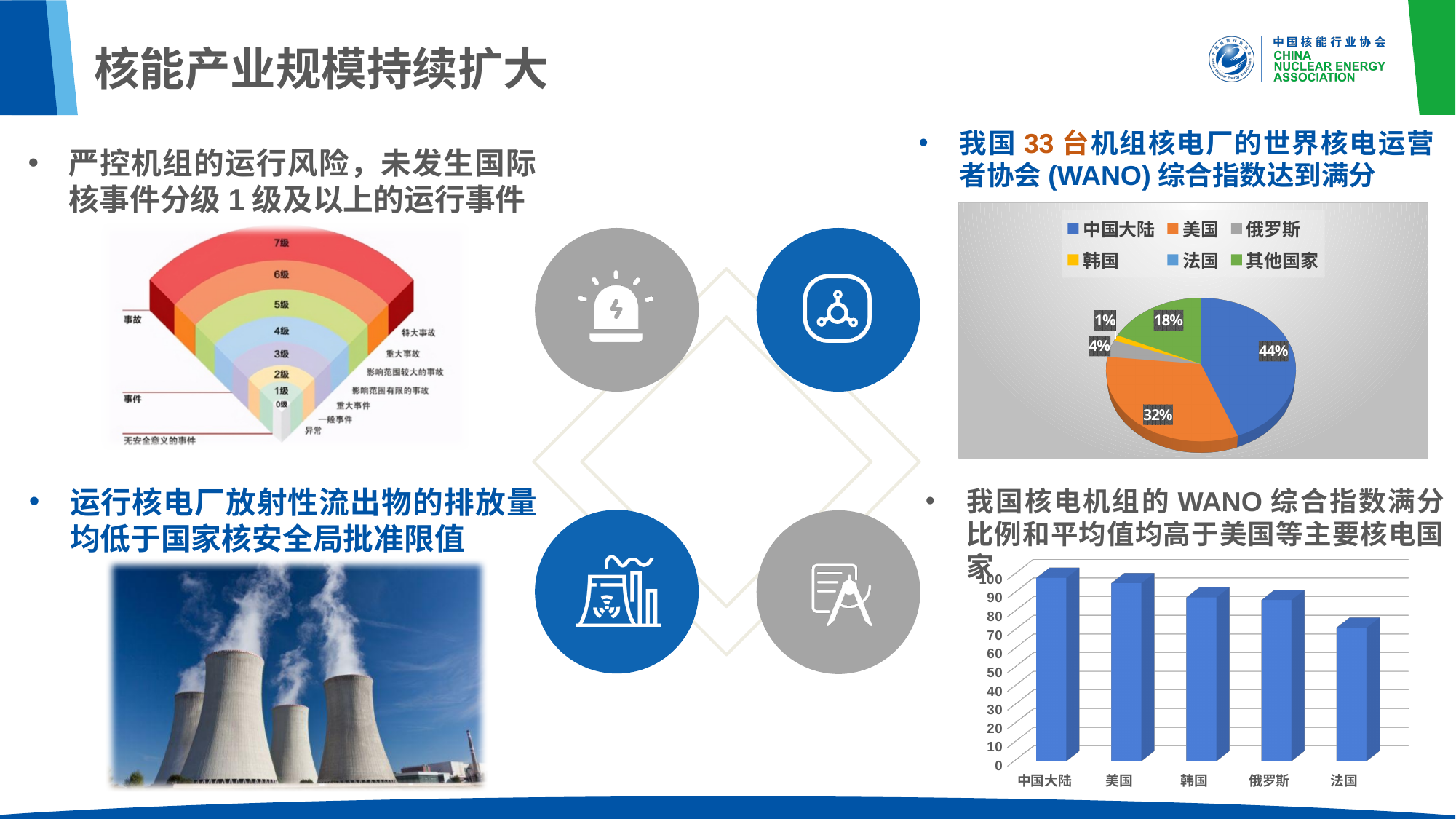
In the pie chart at the top right, which category has the largest slice? 中国大陆 In the pie chart at the top right, what share is shown for 俄罗斯? 4% In the pie chart at the top right, how many entries does the legend list? 6 What kind of chart is the chart at the bottom right of the slide? bar chart In the pie chart at the top right, how many percentage points larger is the 中国大陆 slice than the 美国 slice? 12% In the bar chart at the bottom right, do the bar values rise or fall from left to right along the x axis? fall In the bar chart at the bottom right, is the value for 法国 greater or less than 80? less In the pie chart at the top right, what share is shown for 其他国家? 18% In the pie chart at the top right, what share is shown for 中国大陆? 44% In the pie chart at the top right, what share is shown for 美国? 32% In the bar chart at the bottom right, how many categories are shown on the x axis? 5 In the bar chart at the bottom right, which category has the lowest bar? 法国